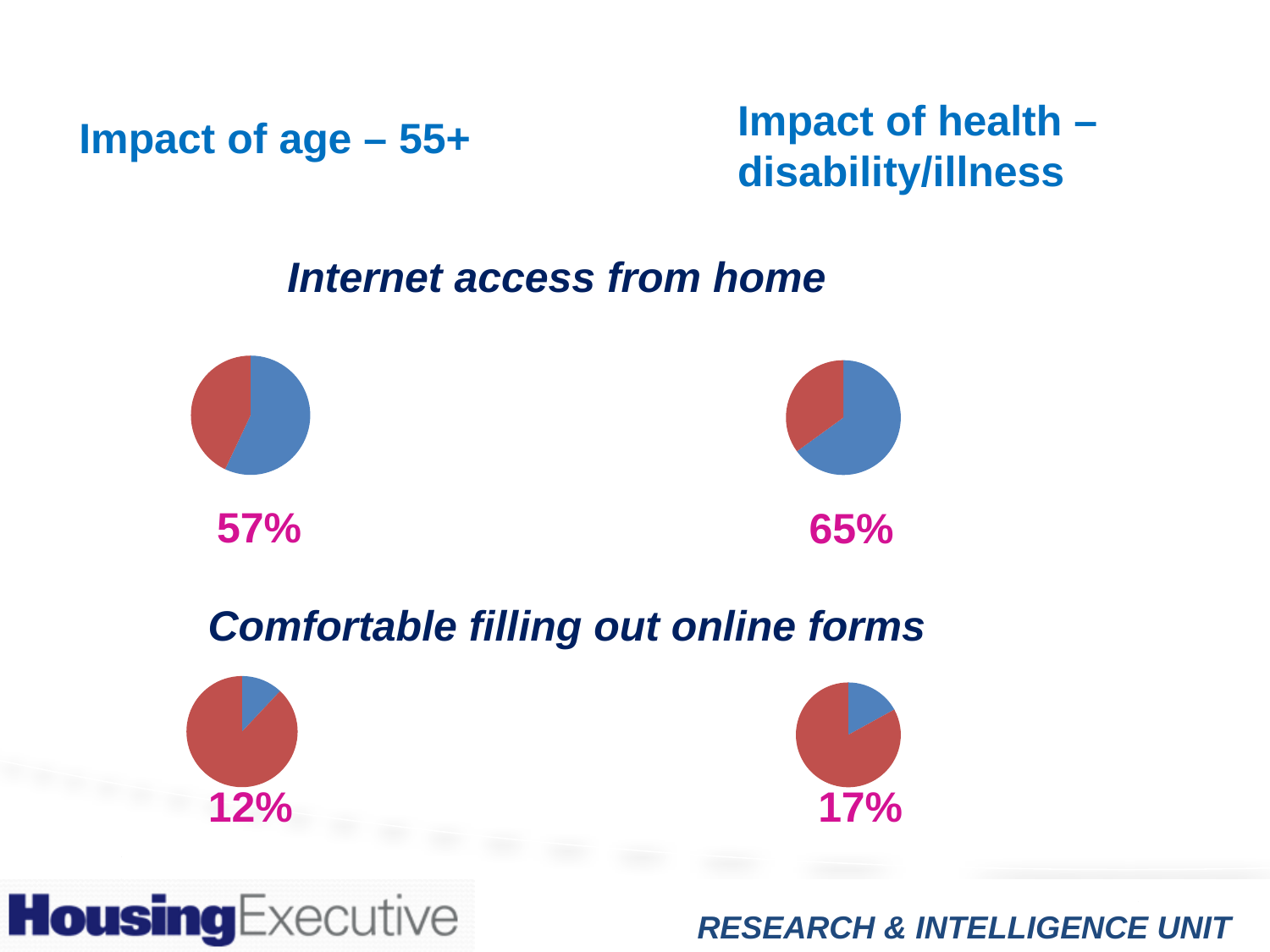
Which of the four pie charts shows the highest percentage? Internet access from home – disability/illness (65%) What is the difference between the 'Internet access from home' percentages for the disability/illness group and the 55+ age group? 8% In the 'Comfortable filling out online forms' pie chart for people with a disability/illness, what percentage is shown? 17% In the 'Internet access from home' pie chart for people with a disability/illness, what percentage is shown? 65% In the 'Comfortable filling out online forms' pie chart for the 55+ age group, what share of the pie does the blue slice represent? 12% How many pie charts are shown on the slide? 4 In the 'Internet access from home' pie chart for the 55+ age group, what percentage is shown? 57% For 'Internet access from home', which group has the higher percentage: the 55+ age group or the disability/illness group? disability/illness What type of chart is used to show 'Internet access from home' for the 55+ age group? pie chart What is the difference between the 'Comfortable filling out online forms' percentages for the disability/illness group and the 55+ age group? 5% For 'Comfortable filling out online forms', which group has the lower percentage: the 55+ age group or the disability/illness group? 55+ In the 'Comfortable filling out online forms' pie chart for the 55+ age group, what percentage is shown? 12%